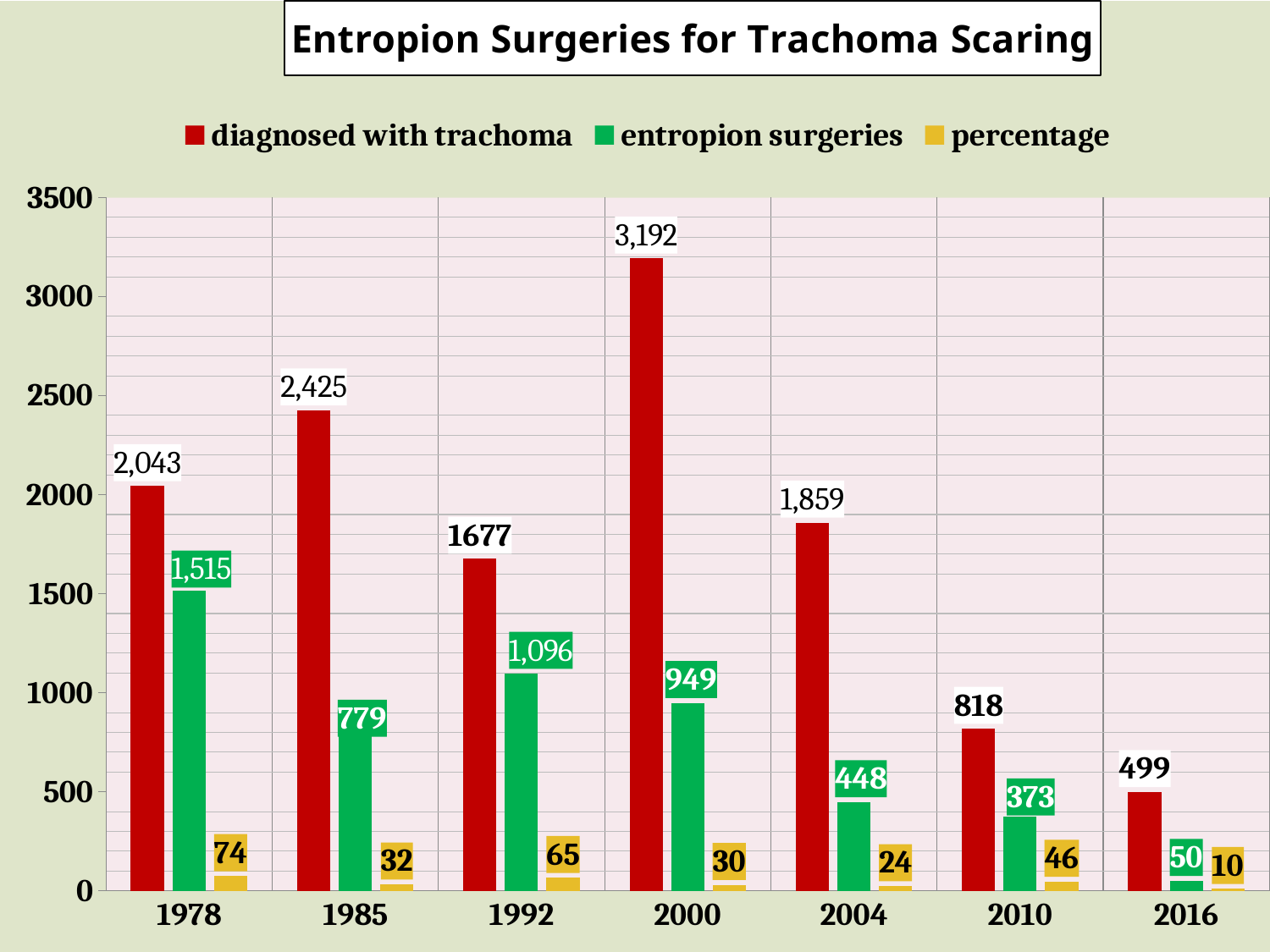
Which year has the highest number diagnosed with trachoma? 2000 How many series does the legend list? 3 How many years are shown on the x axis? 7 What is the title of the chart? Entropion Surgeries for Trachoma Scaring Which is larger: entropion surgeries in 1978 or entropion surgeries in 2000? entropion surgeries in 1978 What is the difference between the number diagnosed with trachoma and the number of entropion surgeries in 1985? 1,646 Is the number diagnosed with trachoma in 2004 greater or less than 2000? less How many entropion surgeries were performed in 1992? 1,096 How many people were diagnosed with trachoma in 2000? 3,192 What is the percentage value shown for 1978? 74 Which year has the lowest number of entropion surgeries? 2016 What kind of chart is shown on the slide? bar chart